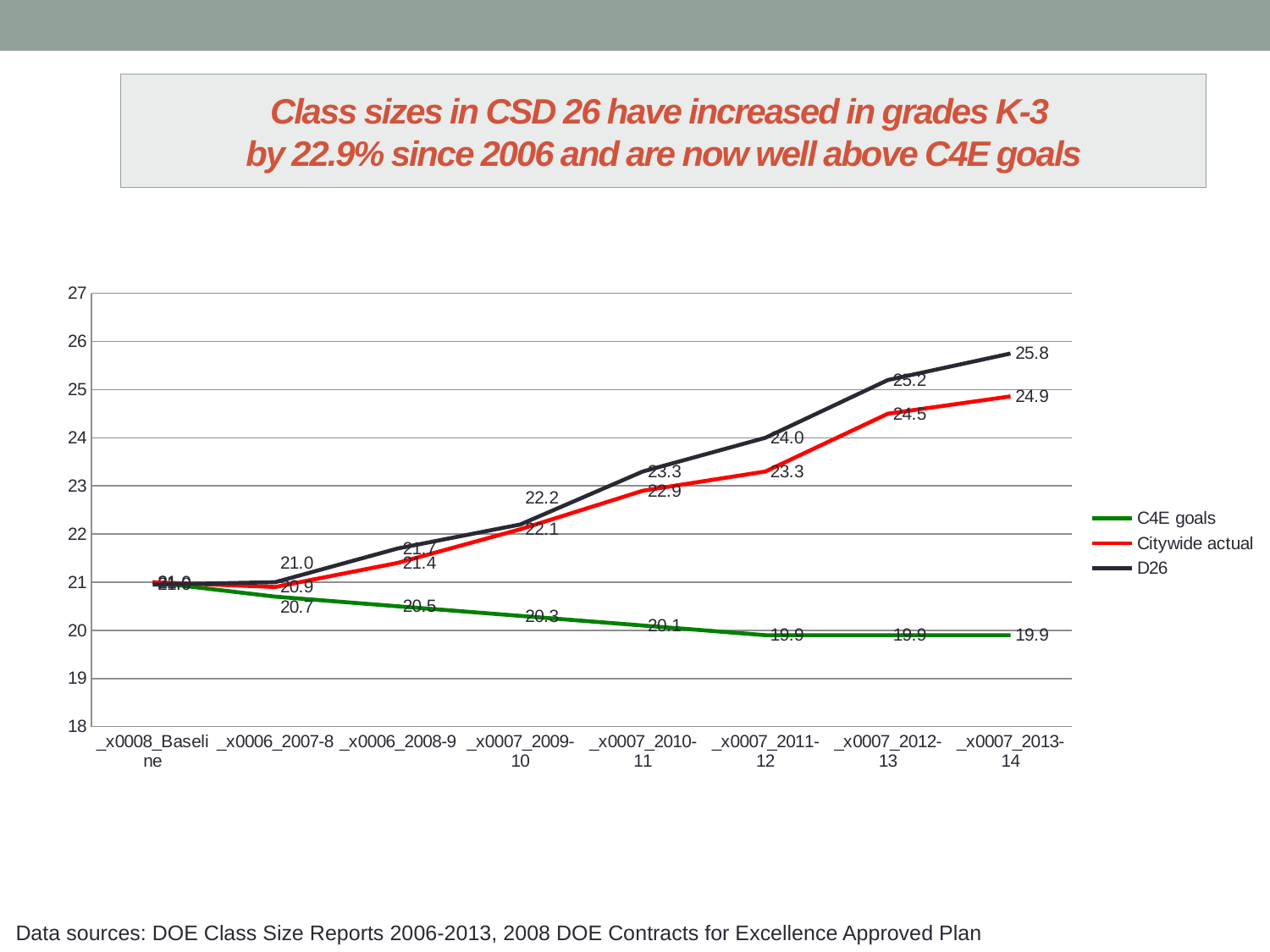
What is the difference between the D26 value and the C4E goals value for 2013-14? 5.9 How many categories are shown along the x axis? 8 Which colour is used for the Citywide actual series? red How many series does the legend list? 3 In which year does the D26 series reach its highest value? 2013-14 What is the C4E goals value for 2009-10? 20.3 What is the D26 value for 2013-14? 25.8 What kind of chart is shown on the slide? line chart What is the lowest value shown for the C4E goals series? 19.9 Does the C4E goals series rise or fall from the Baseline to 2013-14? fall What is the Citywide actual value for 2012-13? 24.5 Which is larger for 2011-12, the D26 value or the Citywide actual value? D26